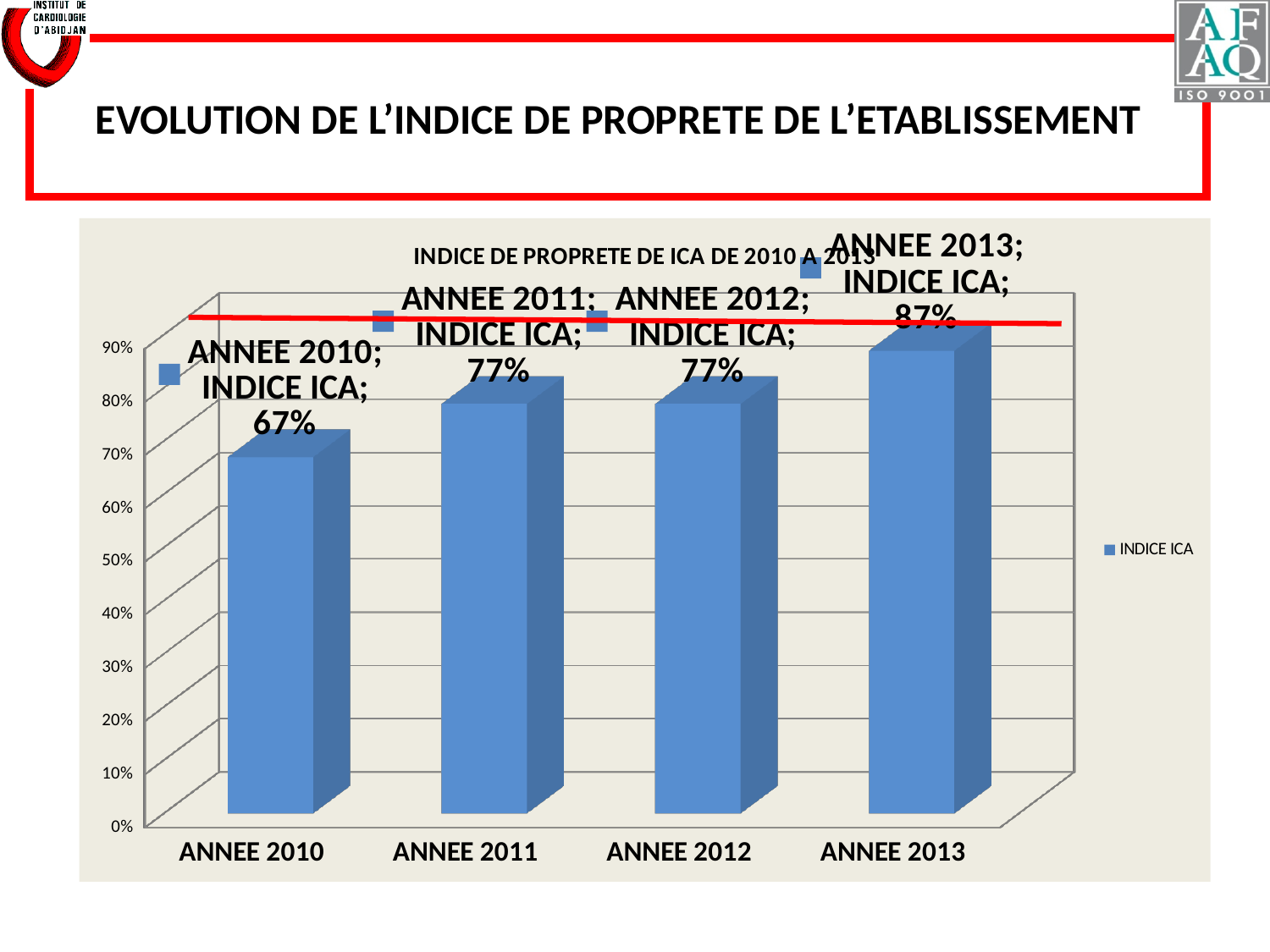
What is the INDICE ICA value for ANNEE 2011? 77% Which year has the lowest INDICE ICA value? ANNEE 2010 Which year has the highest INDICE ICA value? ANNEE 2013 Do the INDICE ICA values rise or fall from ANNEE 2010 to ANNEE 2013? Rise What is the INDICE ICA value for ANNEE 2010? 67% What is the difference between the INDICE ICA values for ANNEE 2013 and ANNEE 2010? 20% How many series does the chart legend list? 1 What is the INDICE ICA value for ANNEE 2013? 87% How many years are shown on the x axis of the chart? 4 What kind of chart is shown on the slide? Bar chart What is the difference between the INDICE ICA values for ANNEE 2011 and ANNEE 2010? 10% Which is larger, the INDICE ICA value for ANNEE 2012 or for ANNEE 2013? ANNEE 2013